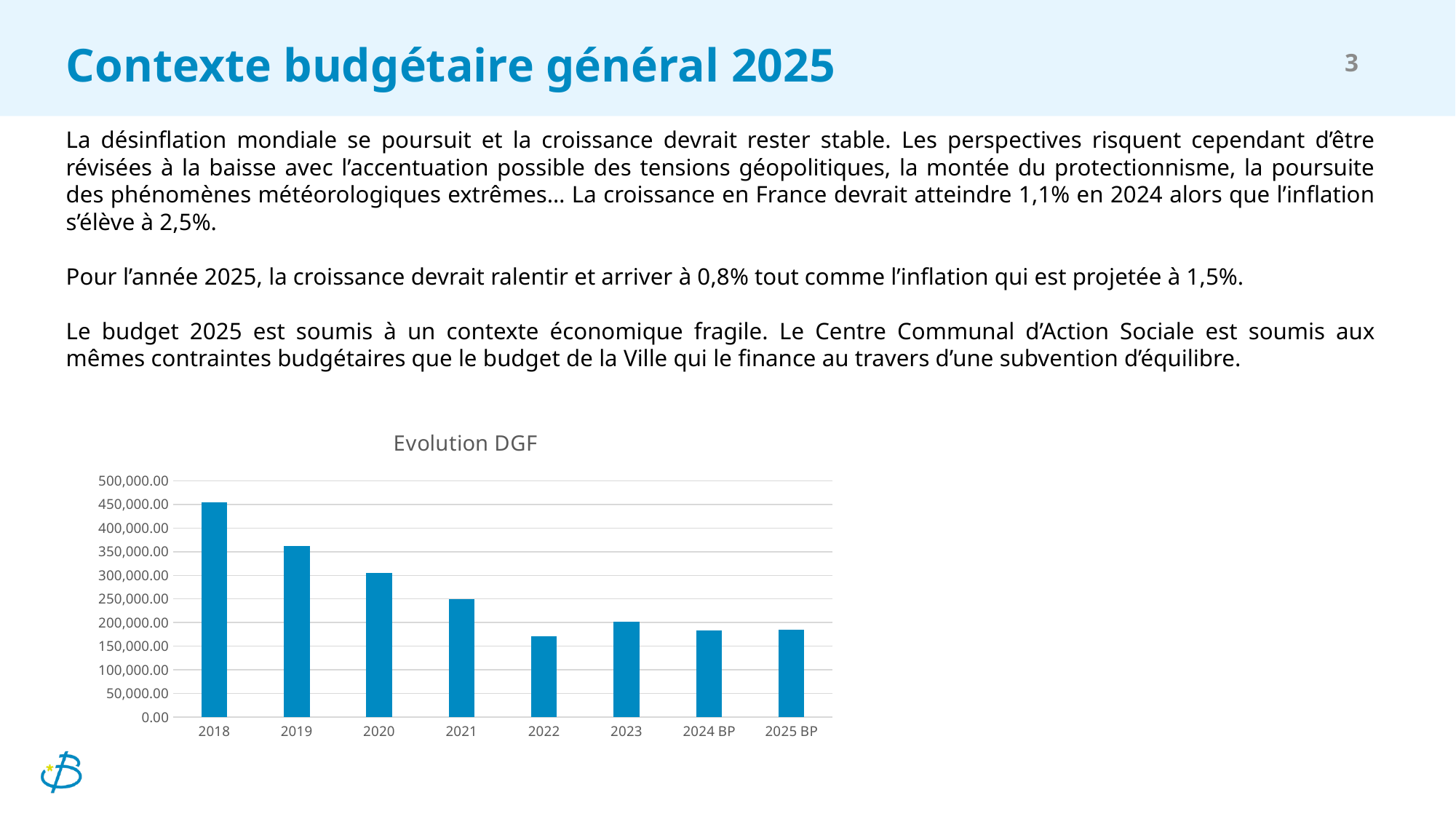
Do the values generally rise or fall from 2018 to 2022? fall What type of chart is shown on the slide? bar chart Which year has the highest DGF value in the chart? 2018 Which is larger, the value for 2022 or the value for 2023? 2023 How many years (categories) are shown on the x axis of the chart? 8 What is the title of the chart? Evolution DGF Is the value for 2022 greater or less than 200,000.00? less Which is larger, the value for 2019 or the value for 2020? 2019 Is the value for 2018 greater or less than 400,000.00? greater Which year has the lowest DGF value in the chart? 2022 Is the value for 2024 BP greater or less than 200,000.00? less